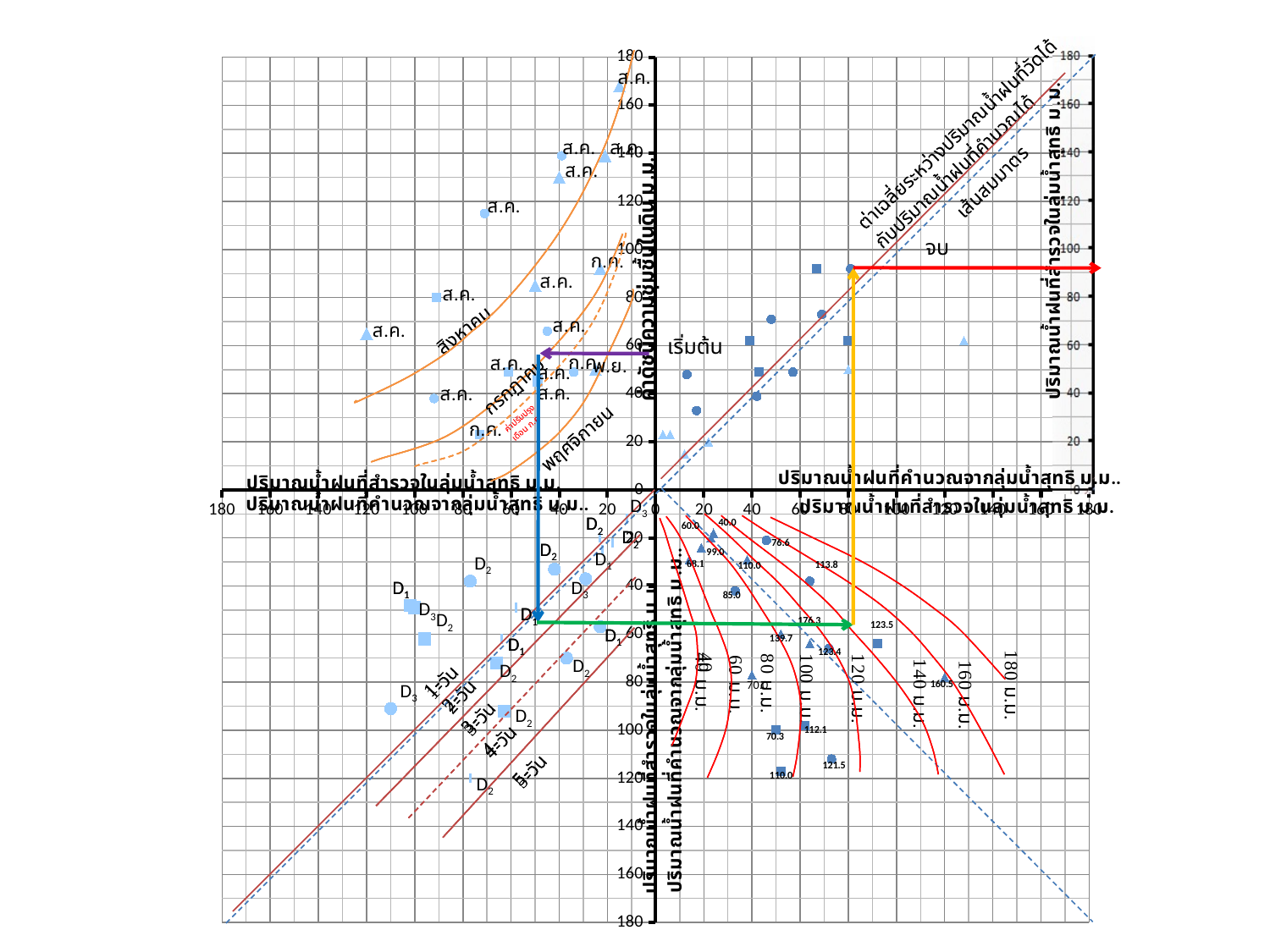
In the lower-right quadrant, is the horizontal-axis value of the point labelled 160.5 greater or less than 100? greater In the lower-right quadrant, is the vertical-axis value of the point labelled 121.5 greater or less than 100? greater What is the interval between consecutive tick marks on the axes? 20 What kind of chart is shown on the slide? scatter chart What is the maximum value shown on the axes of the chart? 180 In the lower-left quadrant, how many lines are labelled with a number of days (วัน)? 5 In the lower-right quadrant, what is the smallest data label printed next to a point? 40.0 In the lower-right quadrant, how many red curves are labelled with a value in ม.ม. (from 40 ม.ม. to 180 ม.ม.)? 8 In the lower-right quadrant, which data label is larger: 176.3 or 123.5? 176.3 In the lower-right quadrant, what is the largest data label printed next to a point? 176.3